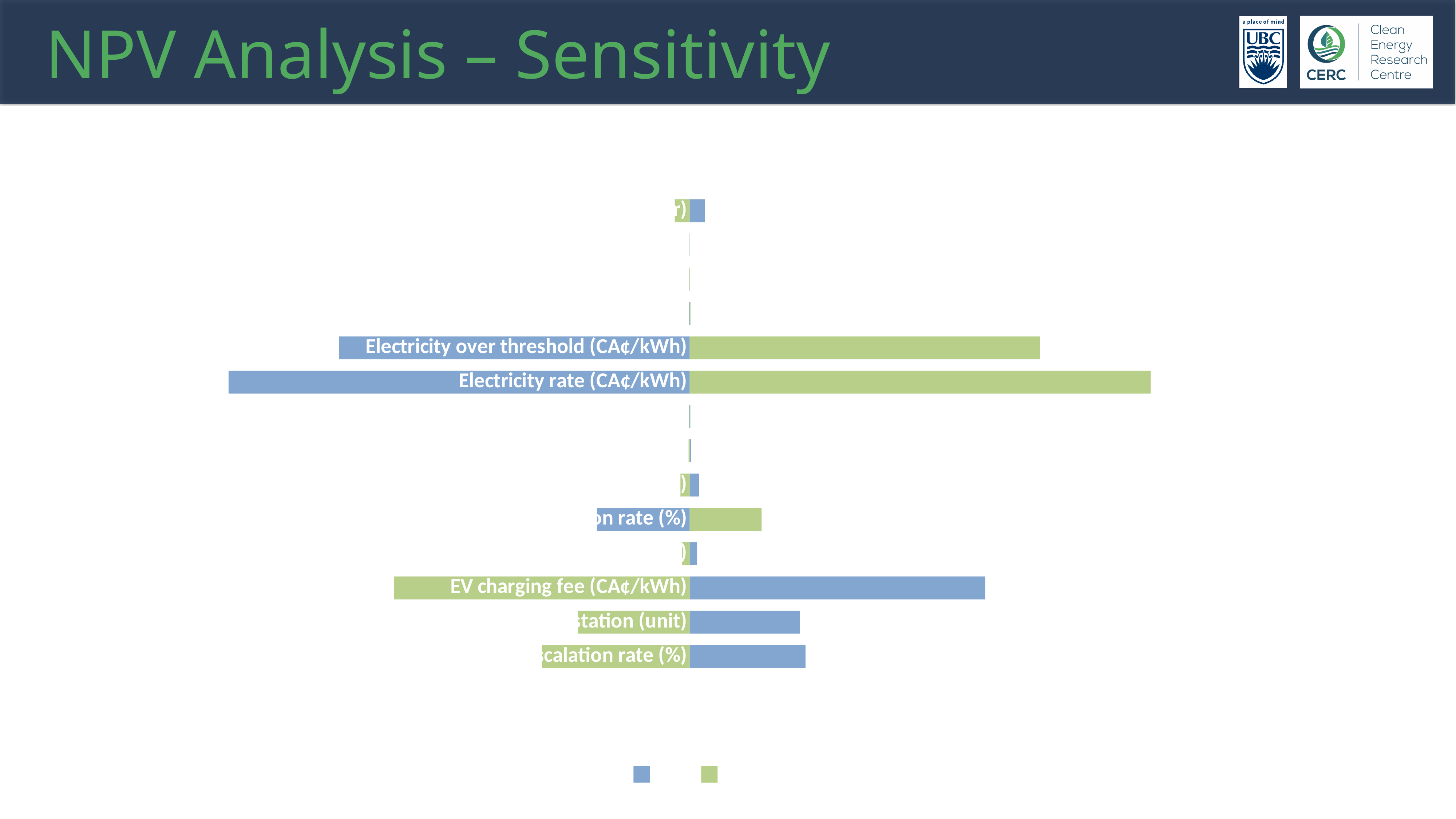
What kind of chart is shown on the slide? bar chart Which category has the widest bars in the chart? Electricity rate (CA¢/kWh) For EV charging fee (CA¢/kWh), which colour bar extends to the right of the centre line? blue Which has the wider bars: Electricity over threshold (CA¢/kWh) or EV charging fee (CA¢/kWh)? Electricity over threshold (CA¢/kWh) What two colours are used for the bars in the chart? blue and green How many series does the chart's legend list? 2 Which has the wider bars: Electricity rate (CA¢/kWh) or Electricity over threshold (CA¢/kWh)? Electricity rate (CA¢/kWh) Of Electricity rate (CA¢/kWh), Electricity over threshold (CA¢/kWh) and EV charging fee (CA¢/kWh), which has the narrowest bars? EV charging fee (CA¢/kWh)